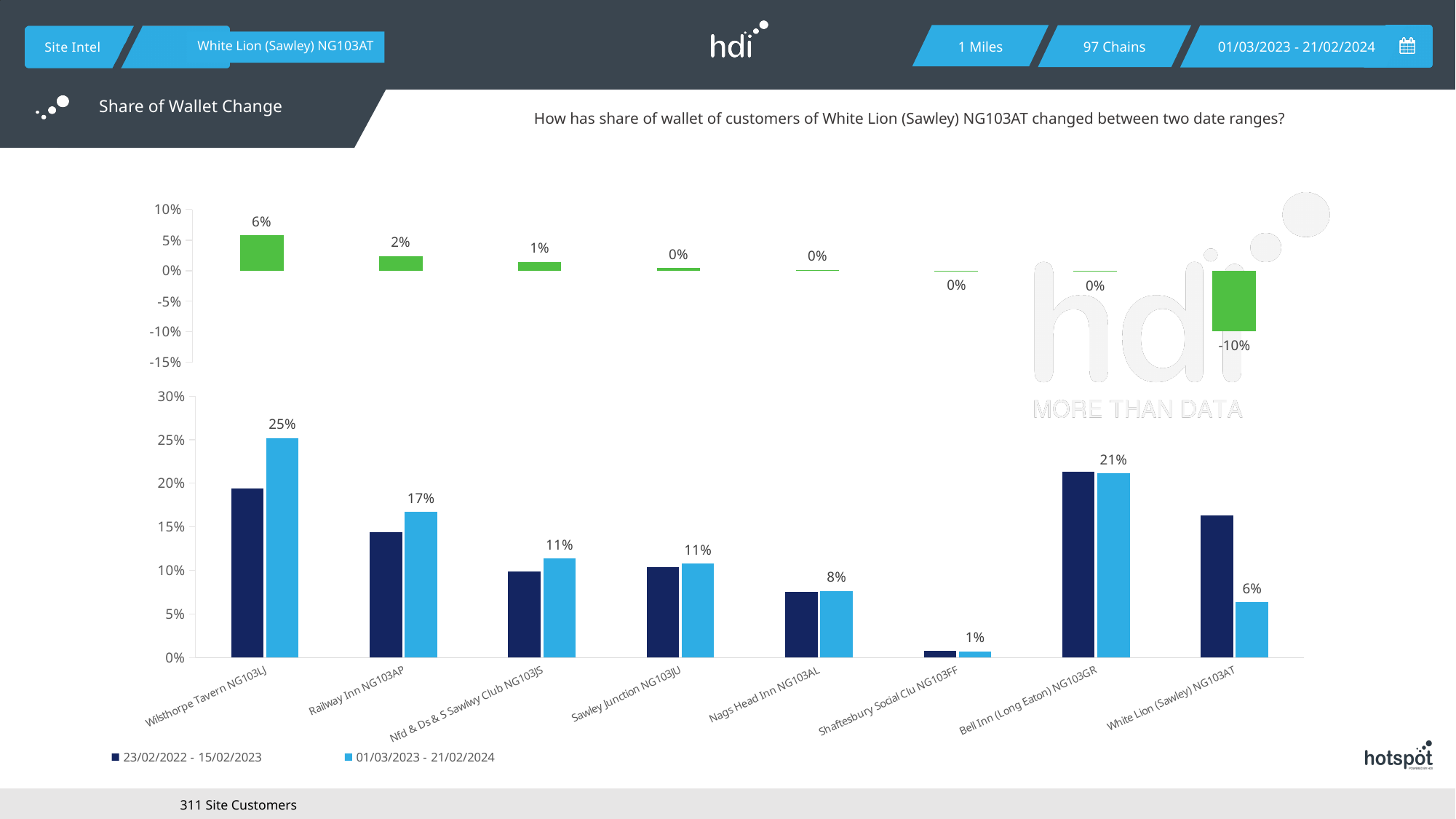
In the top chart (share of wallet change), which category has the highest value? Wilsthorpe Tavern NG103LJ In the bottom chart, is the 23/02/2022 - 15/02/2023 value for Wilsthorpe Tavern NG103LJ greater or less than 15%? greater In the bottom chart, for White Lion (Sawley) NG103AT, which series has the larger value? 23/02/2022 - 15/02/2023 In the bottom chart, what is the value for Railway Inn NG103AP in the 01/03/2023 - 21/02/2024 series? 17% In the bottom chart, what is the difference between the 01/03/2023 - 21/02/2024 values for Wilsthorpe Tavern NG103LJ and White Lion (Sawley) NG103AT? 19 percentage points In the top chart (share of wallet change), what is the value for White Lion (Sawley) NG103AT? -10% In the top chart (share of wallet change), which category has the lowest value? White Lion (Sawley) NG103AT What kind of chart is the bottom chart? bar chart In the bottom chart, what is the value for Bell Inn (Long Eaton) NG103GR in the 01/03/2023 - 21/02/2024 series? 21% How many categories are shown on the x axis of the bottom chart? 8 In the top chart (share of wallet change), what is the value for Wilsthorpe Tavern NG103LJ? 6% How many series does the legend of the bottom chart list? 2